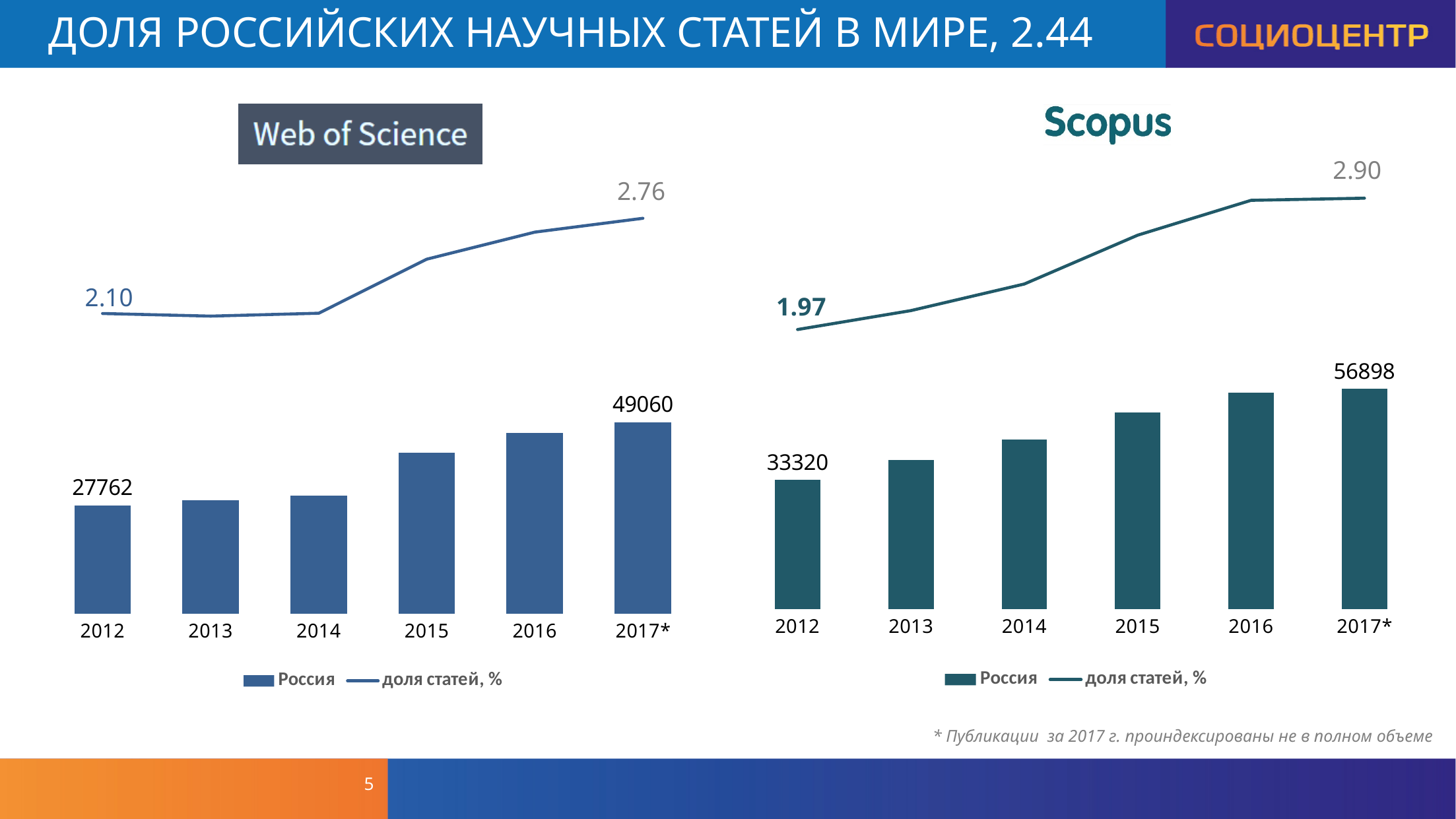
In the Scopus chart, what is the value of the Россия bar for 2017*? 56898 In the Web of Science chart, what is the value of the Россия bar for 2012? 27762 In the Scopus chart, what is the difference between the Россия bar values for 2017* and 2012? 23578 In the Scopus chart, what is the value of the доля статей, % line for 2012? 1.97 In the Web of Science chart, which year has the lowest Россия bar? 2012 In the Scopus chart, which year has the highest Россия bar? 2017* In the Web of Science chart, what is the value of the доля статей, % line for 2017*? 2.76 How many series does the legend of the Scopus chart list? 2 Which is larger: the 2017* Россия bar in the Scopus chart or the 2017* Россия bar in the Web of Science chart? Scopus How many years are shown on the x axis of the Web of Science chart? 6 In the Web of Science chart, what is the value of the Россия bar for 2017*? 49060 In the Web of Science chart, what is the difference between the доля статей, % values for 2017* and 2012? 0.66